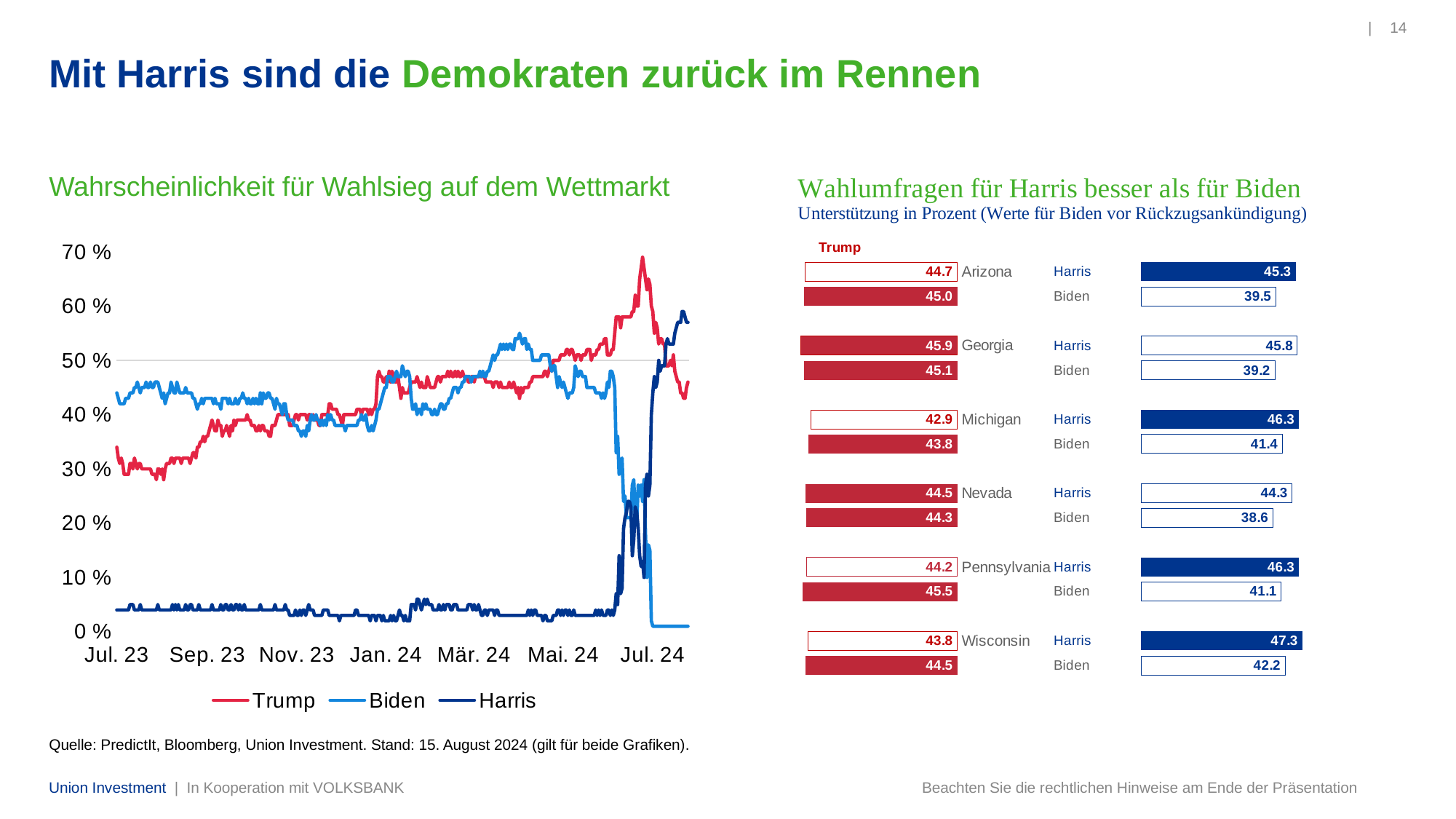
In the right chart, what is the difference between Harris's and Biden's support values in Michigan? 4.9 In the left chart, is the value for Biden at the end of the series (Jul. 24 onward) greater or less than 10 %? less What kind of chart is the left chart (Wahrscheinlichkeit für Wahlsieg auf dem Wettmarkt)? Line chart In the left chart, does the Harris line rise or fall from Jul. 24 to the end of the series? Rises In the right chart, what is the support value for Biden in Nevada? 38.6 In the right chart, what is Trump's support value in the row paired with Harris in Michigan? 42.9 In the right chart, in which state does Biden have the lowest support value? Nevada In the right chart (Wahlumfragen für Harris besser als für Biden), what is the support value for Harris in Wisconsin? 47.3 How many states are shown in the right chart? 6 In the right chart, who has the higher support value in Pennsylvania, Harris or Biden? Harris In the right chart, in which state does Harris have the highest support value? Wisconsin How many series does the legend of the left chart (Wahrscheinlichkeit für Wahlsieg auf dem Wettmarkt) list? 3